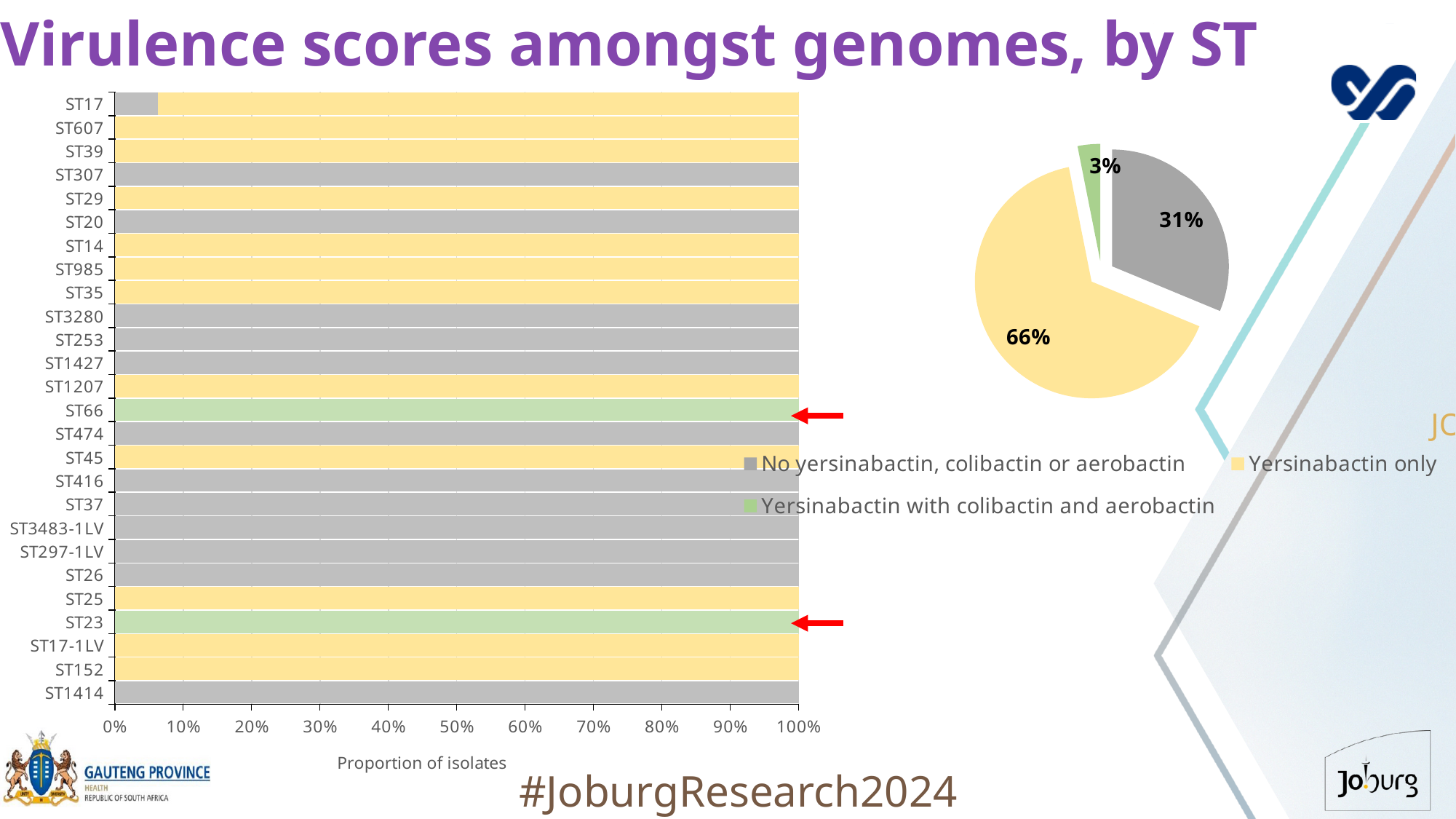
In the pie chart, what share of isolates has 'No yersinabactin, colibactin or aerobactin'? 31% How many ST categories are shown on the bar chart on the left? 26 In the pie chart, which is larger: the 'Yersinabactin only' slice or the 'No yersinabactin, colibactin or aerobactin' slice? Yersinabactin only In the bar chart on the left, what proportion of ST66 isolates are 'Yersinabactin with colibactin and aerobactin'? 100% In the pie chart, which category has the smallest slice? Yersinabactin with colibactin and aerobactin In the pie chart, which category has the largest slice? Yersinabactin only In the pie chart, what share of isolates is 'Yersinabactin only'? 66% In the bar chart on the left, is the 'Yersinabactin only' proportion for ST17 greater or less than 90%? greater In the pie chart, what is the difference in percentage points between the 'Yersinabactin only' slice and the 'No yersinabactin, colibactin or aerobactin' slice? 35 percentage points In the pie chart, what share of isolates is 'Yersinabactin with colibactin and aerobactin'? 3% How many series does the legend list? 3 What kind of chart is the chart on the left of the slide? Bar chart